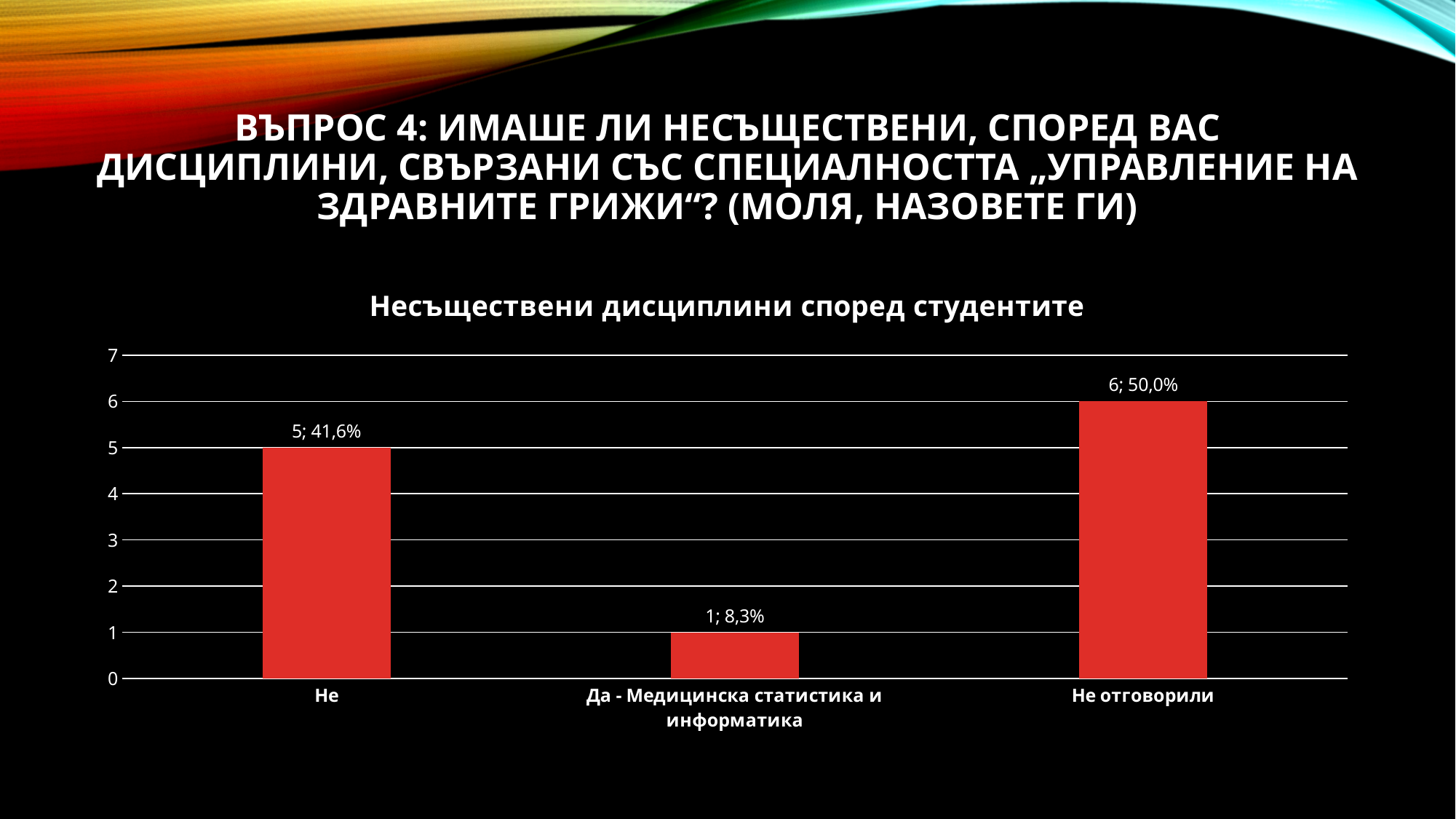
What kind of chart is shown on the slide? bar chart Which category has the lowest value? Да - Медицинска статистика и информатика Is the value for "Не" greater or less than 3? greater Which category has the highest value? Не отговорили What is the difference in count between "Не отговорили" and "Не"? 1 How many categories are shown on the chart? 3 What is the value for "Не"? 5; 41,6% What is the value for "Не отговорили"? 6; 50,0% Which is larger, the value for "Не" or the value for "Не отговорили"? Не отговорили What is the title of the chart? Несъществени дисциплини според студентите What is the value for "Да - Медицинска статистика и информатика"? 1; 8,3% What is the difference in count between "Не" and "Да - Медицинска статистика и информатика"? 4